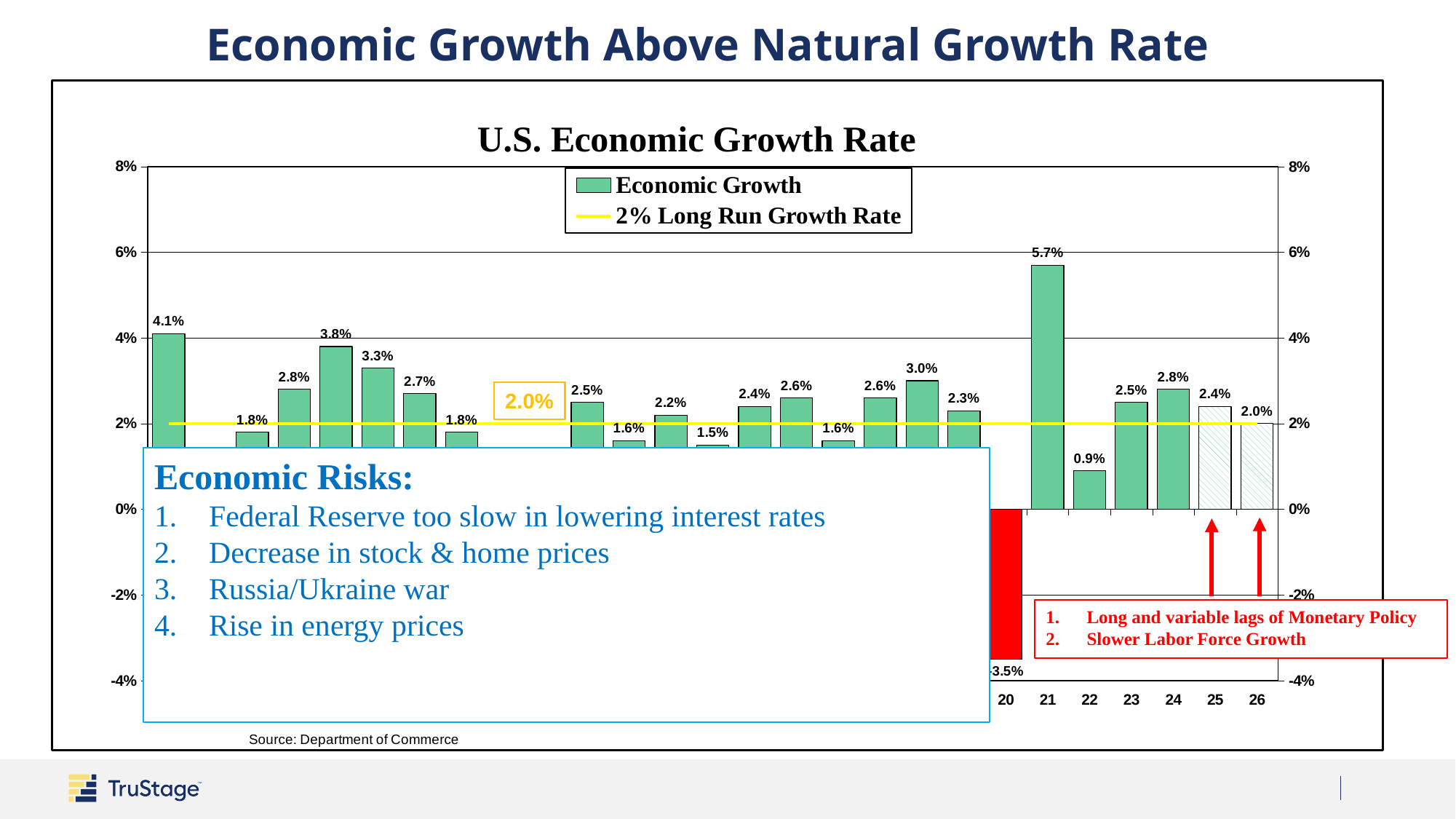
Which year shown on the chart has the lowest economic growth rate? 20 How many series does the legend list? 2 What is the economic growth rate for 21? 5.7% What is the economic growth rate for 26? 2.0% Which year shown on the chart has the highest economic growth rate? 21 What is the difference between the economic growth rate for 21 and for 22? 4.8% What value does the yellow line represent according to the legend? 2% Long Run Growth Rate What is the economic growth rate for 22? 0.9% Which has a higher economic growth rate, 23 or 25? 23 What is the title of the chart? U.S. Economic Growth Rate What type of chart is used to show Economic Growth? bar chart What is the economic growth rate for 24? 2.8%